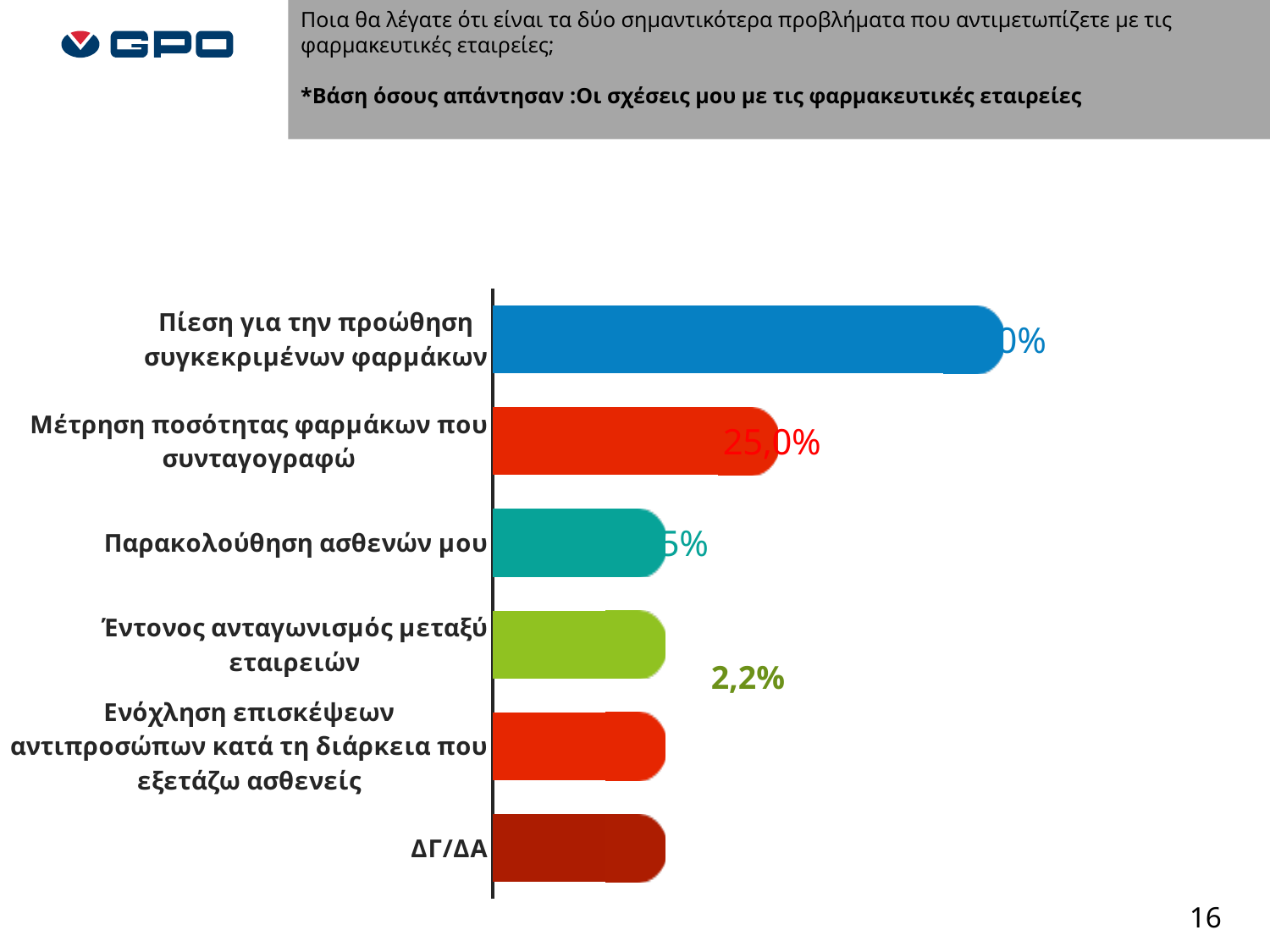
What type of chart is shown on the slide? bar chart Which is larger: the value for 'Πίεση για την προώθηση συγκεκριμένων φαρμάκων' or for 'Μέτρηση ποσότητας φαρμάκων που συνταγογραφώ'? Πίεση για την προώθηση συγκεκριμένων φαρμάκων How many categories are shown in the chart? 6 What is the value for 'Μέτρηση ποσότητας φαρμάκων που συνταγογραφώ'? 25,0% Which is larger: the value for 'Παρακολούθηση ασθενών μου' or for 'ΔΓ/ΔΑ'? They are equal Which is larger: the value for 'Μέτρηση ποσότητας φαρμάκων που συνταγογραφώ' or for 'Παρακολούθηση ασθενών μου'? Μέτρηση ποσότητας φαρμάκων που συνταγογραφώ What colour is the bar for 'Πίεση για την προώθηση συγκεκριμένων φαρμάκων'? blue Which category is listed last (at the bottom) of the chart? ΔΓ/ΔΑ Which category has the highest value in the chart? Πίεση για την προώθηση συγκεκριμένων φαρμάκων